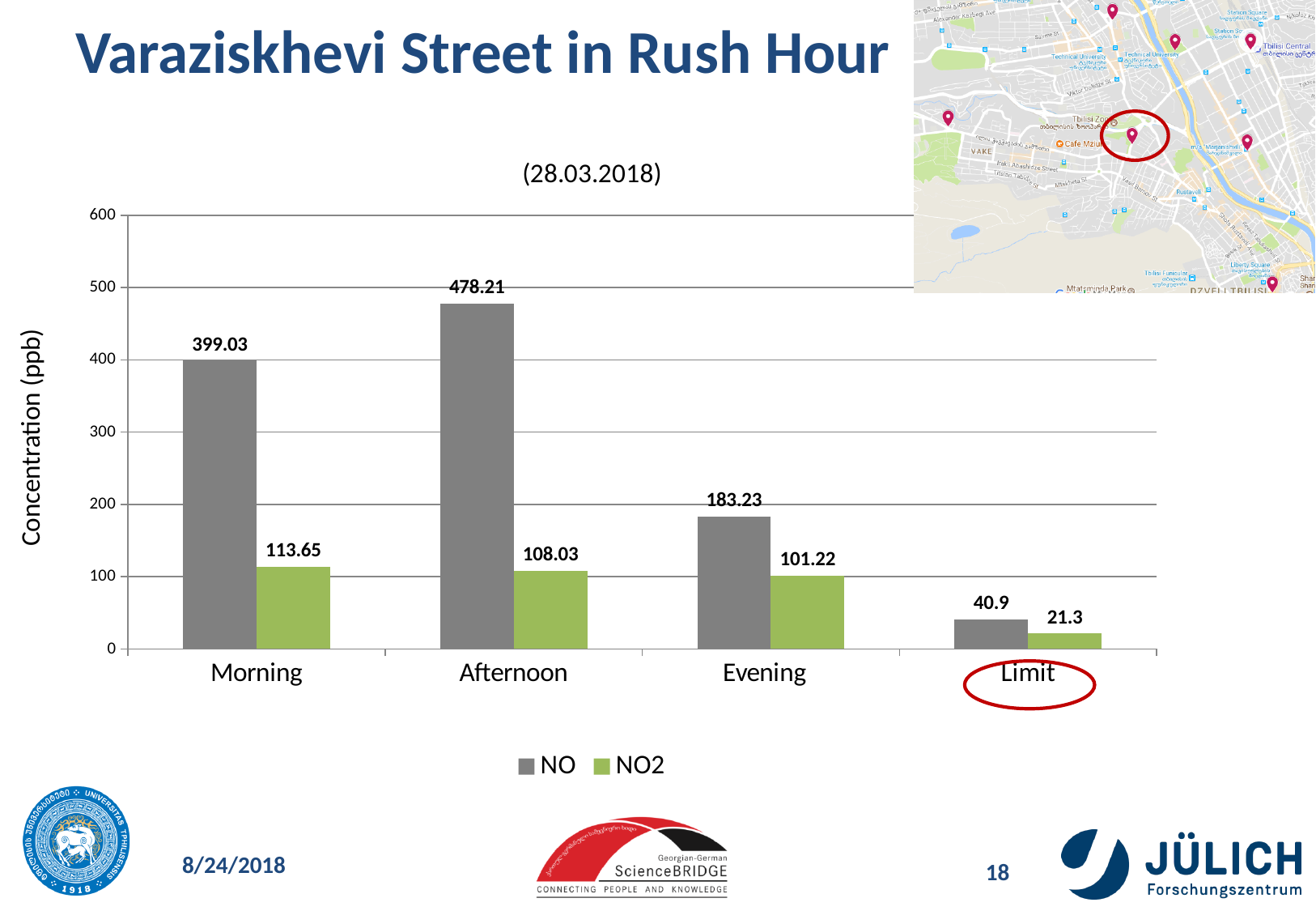
What is the NO value for the Limit category? 40.9 Which category has the lowest NO2 concentration? Limit Is the NO value for the Evening greater or less than 200? less What kind of chart is shown on the slide? bar chart What is the NO2 concentration in the Morning? 113.65 How many series does the legend list? 2 How many categories are shown on the x axis? 4 Which is larger, the NO2 value in the Afternoon or in the Evening? Afternoon What is the NO concentration in the Afternoon? 478.21 What is the difference between the NO concentrations in the Afternoon and the Morning? 79.18 What is the label of the y axis? Concentration (ppb) Which category has the highest NO concentration? Afternoon